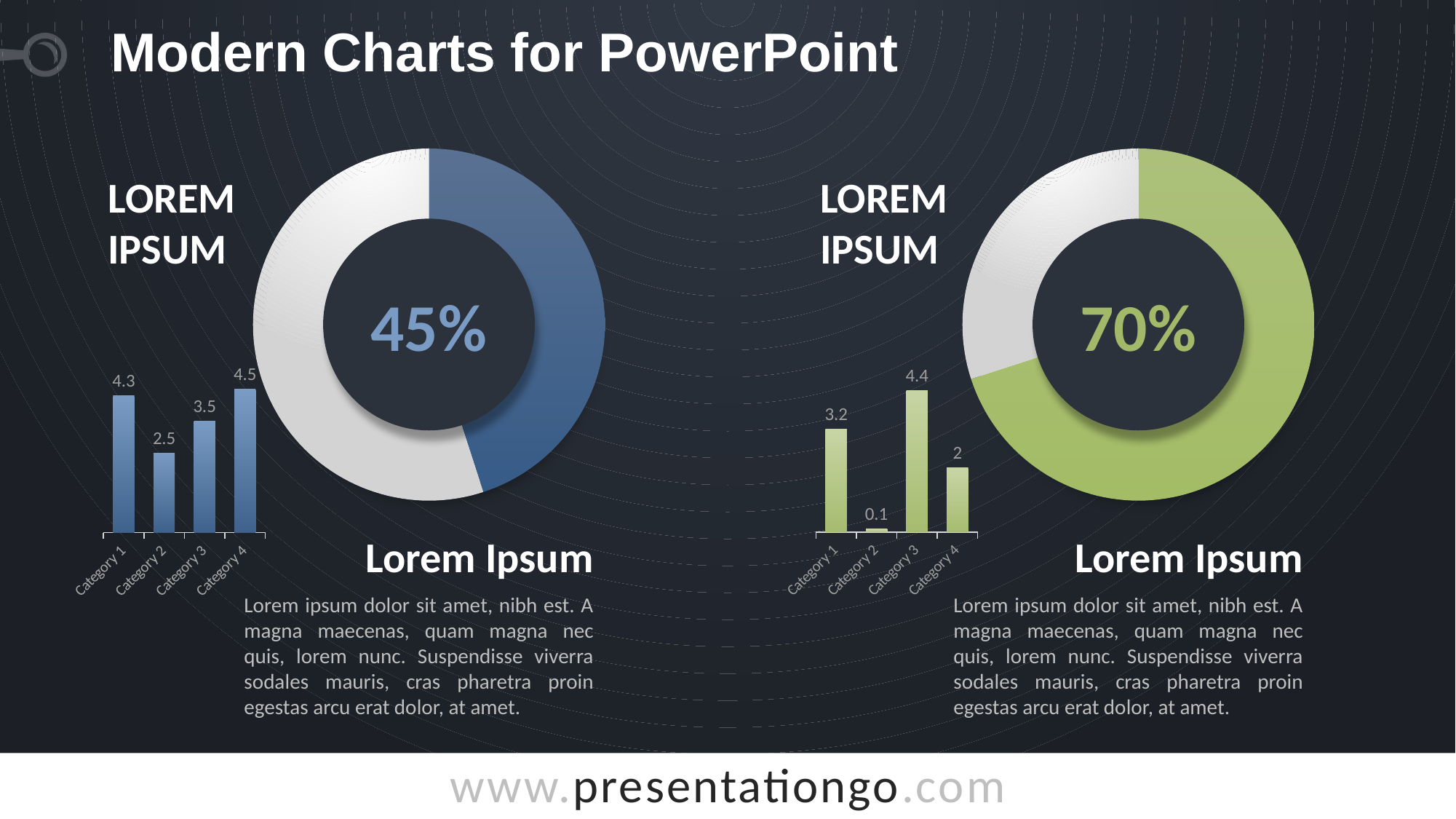
In the blue bar chart on the left, which category has the highest value? Category 4 In the blue bar chart on the left, what is the difference between the values for Category 4 and Category 1? 0.2 In the blue bar chart on the left, which category has the lowest value? Category 2 What percentage is shown in the centre of the green donut chart on the right? 70% What kind of chart is the large blue ring chart on the left? Donut chart In the green bar chart on the right, what is the difference between the values for Category 1 and Category 4? 1.2 In the blue bar chart on the left, what is the value for Category 2? 2.5 In the green bar chart on the right, what is the value for Category 3? 4.4 In the green bar chart on the right, which category has the lowest value? Category 2 How many categories does the blue bar chart on the left show? 4 In the green bar chart on the right, which is larger, the value for Category 1 or Category 4? Category 1 What percentage is shown in the centre of the blue donut chart on the left? 45%